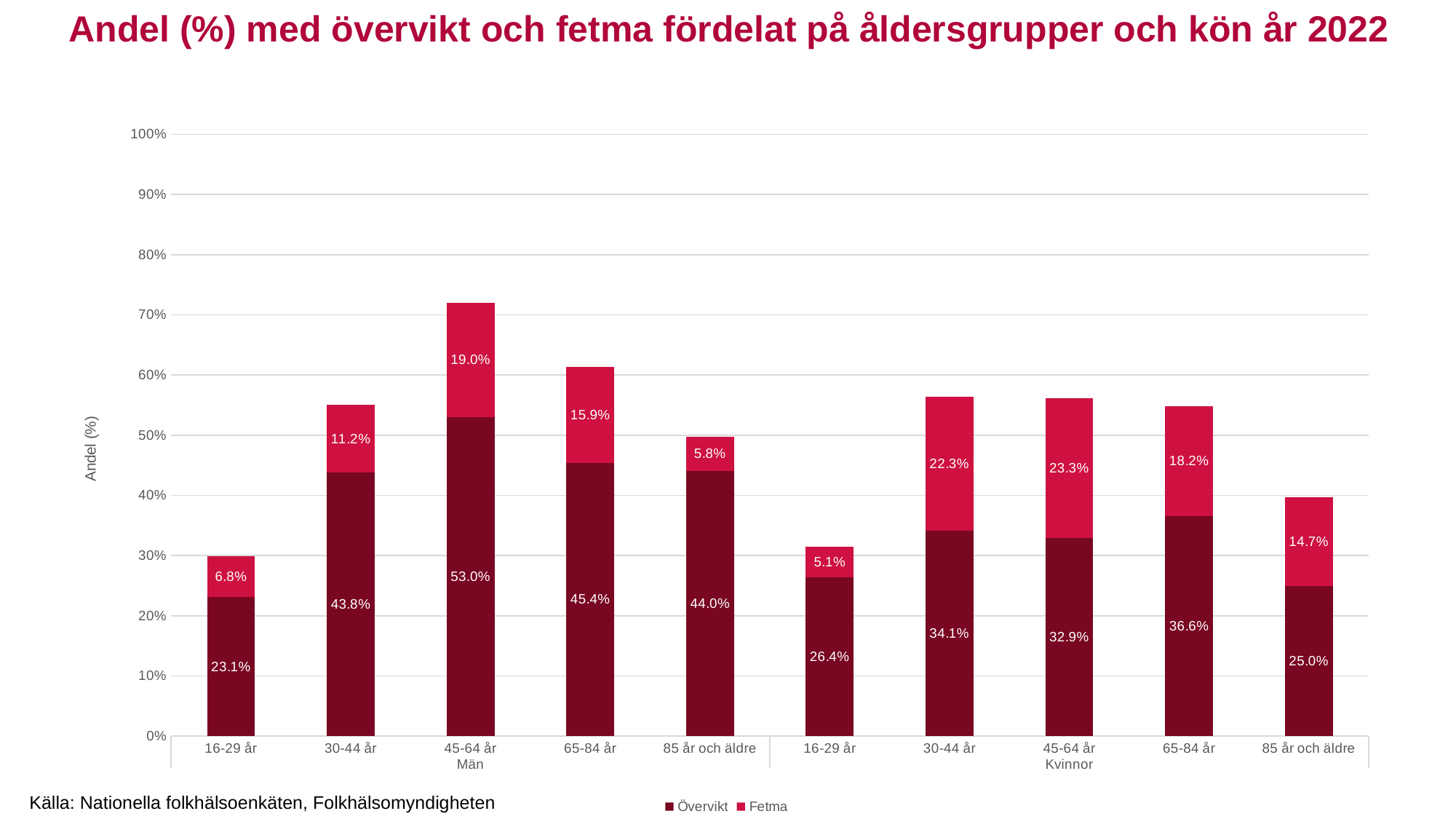
How many series does the legend list? 2 Which is larger: the Övervikt value for men aged 65-84 år or for women aged 65-84 år? Men aged 65-84 år (45.4%) What kind of chart is shown on the slide? Stacked bar chart Which age group among women has the lowest Fetma value? 16-29 år What is the total of the stacked bar for women aged 85 år och äldre? 39.7% What is the Övervikt value for men aged 45-64 år? 53.0% What is the difference between the Fetma values for women aged 30-44 år and men aged 30-44 år? 11.1% Which age group among men has the highest Övervikt value? 45-64 år What is the total of the stacked bar for men aged 45-64 år? 72.0% How many bars are shown in the chart? 10 What is the Fetma value for men aged 85 år och äldre? 5.8% What is the Fetma value for women aged 45-64 år? 23.3%